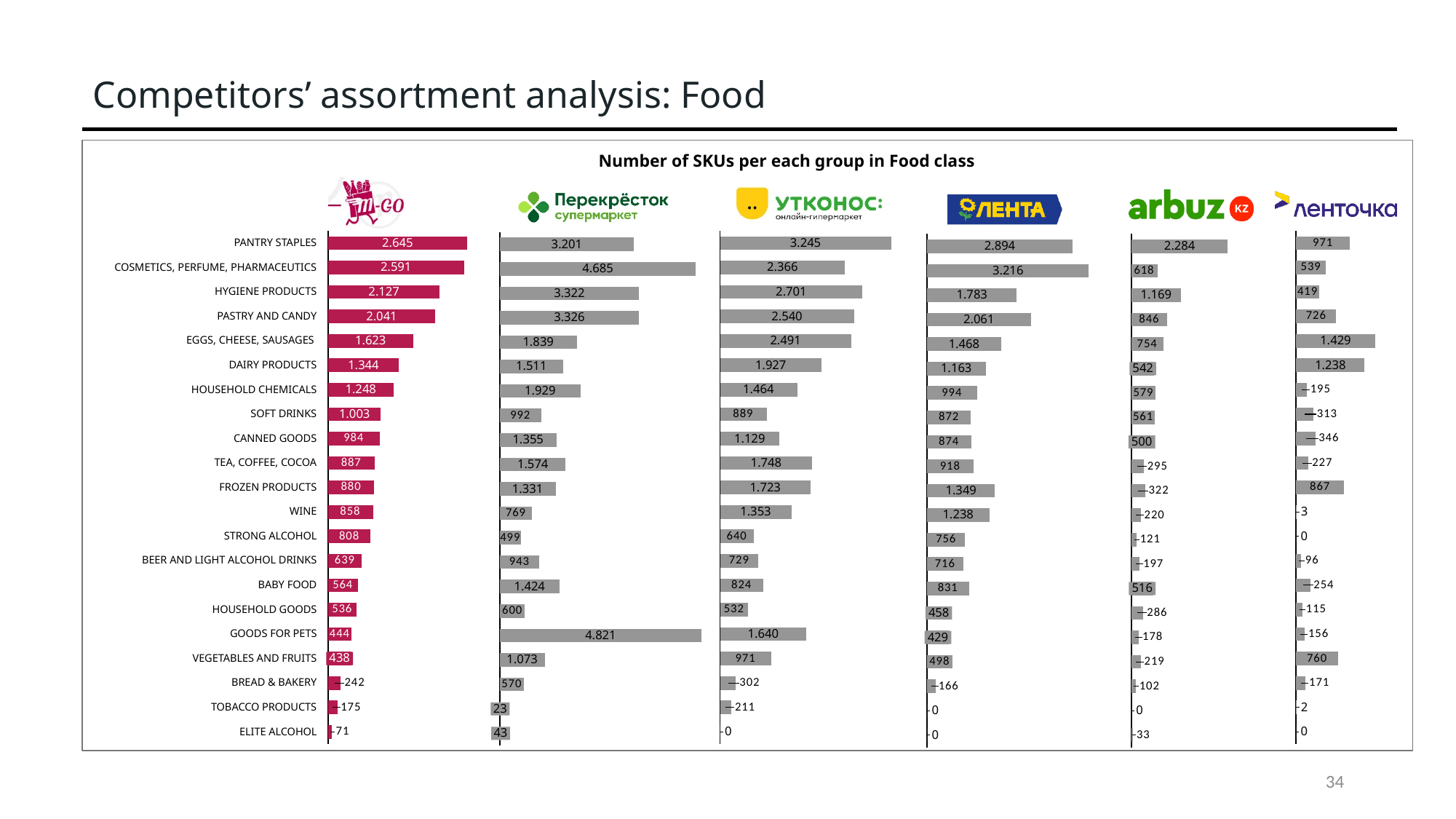
In the Перекрёсток chart, what is the number of SKUs for Goods for Pets? 4.821 In the Утконос chart, which category has the lowest value? Elite Alcohol How many product categories are listed on the slide? 21 In the leftmost chart (red bars), what is the difference between Pantry Staples and Cosmetics, Perfume, Pharmaceutics? 54 What is the title shown above the charts? Number of SKUs per each group in Food class In the Утконос chart, what is the value for Pantry Staples? 3.245 What kind of chart is used on this slide? Bar chart In the Лента chart, what is the difference between Cosmetics, Perfume, Pharmaceutics and Pantry Staples? 322 In the arbuz chart, which is larger: Pantry Staples or Hygiene Products? Pantry Staples In the Перекрёсток chart, which category has the highest number of SKUs? Goods for Pets In the leftmost chart (red bars), which category has the highest value? Pantry Staples In the ленточка chart (rightmost), what is the value for Eggs, Cheese, Sausages? 1.429